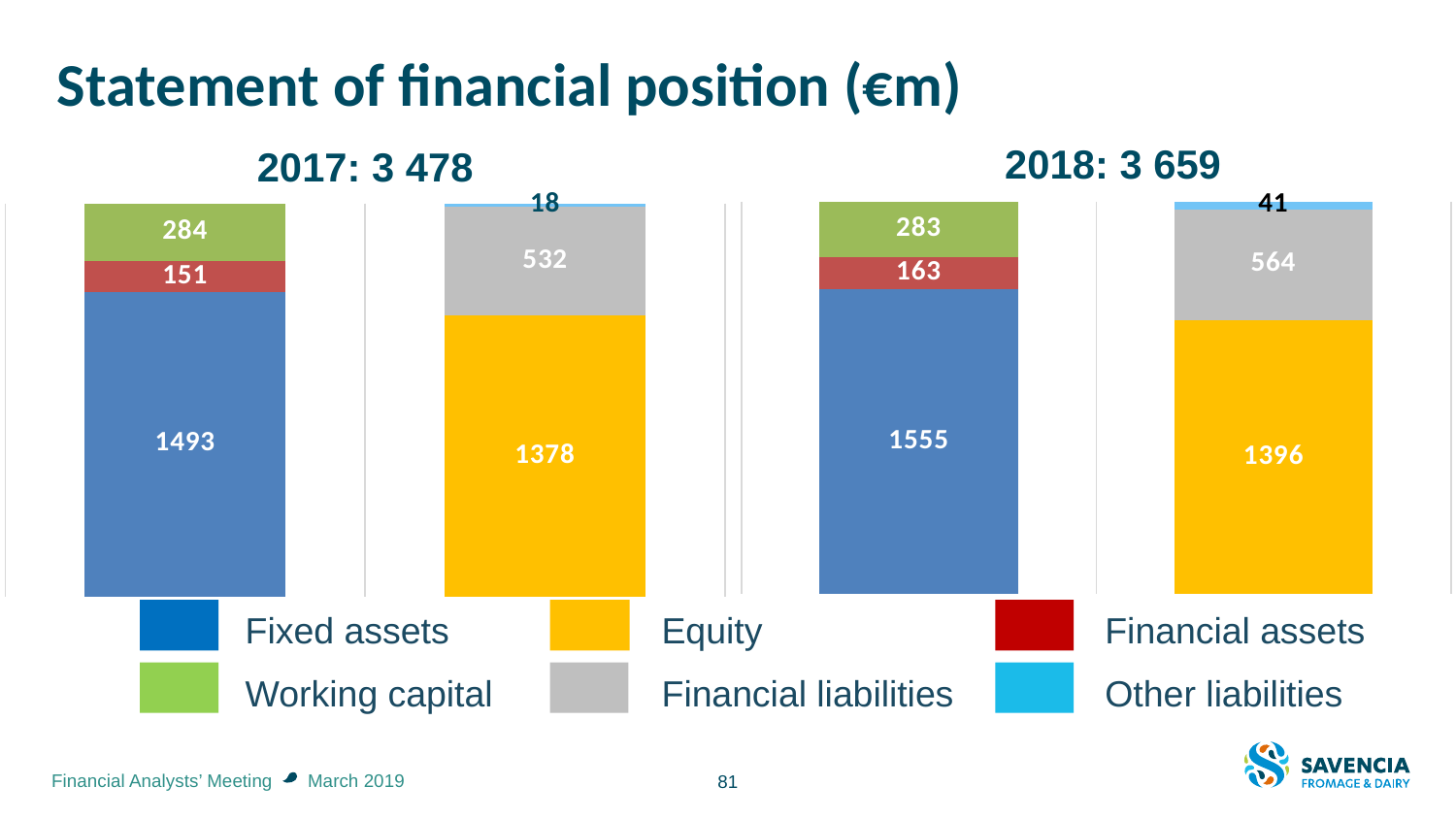
In the 2017 chart, what is the total of the stacked bar made up of Fixed assets, Financial assets and Working capital? 1928 What is the difference between Fixed assets in 2018 and Fixed assets in 2017? 62 In the 2017 chart, what is the value for Fixed assets? 1493 In the 2017 chart, what is the value for Financial liabilities? 532 In the 2018 chart, what is the value for Equity? 1396 In the 2018 chart, which segment has the largest value? Fixed assets Which is larger in the 2018 chart: Working capital or Financial assets? Working capital What type of chart is used on this slide? Stacked bar chart In the 2018 chart, what is the value for Other liabilities? 41 In the 2018 chart, what is the total of the stacked bar made up of Equity, Financial liabilities and Other liabilities? 2001 In the 2017 chart, which segment has the smallest value? Other liabilities How many entries does the legend list? 6